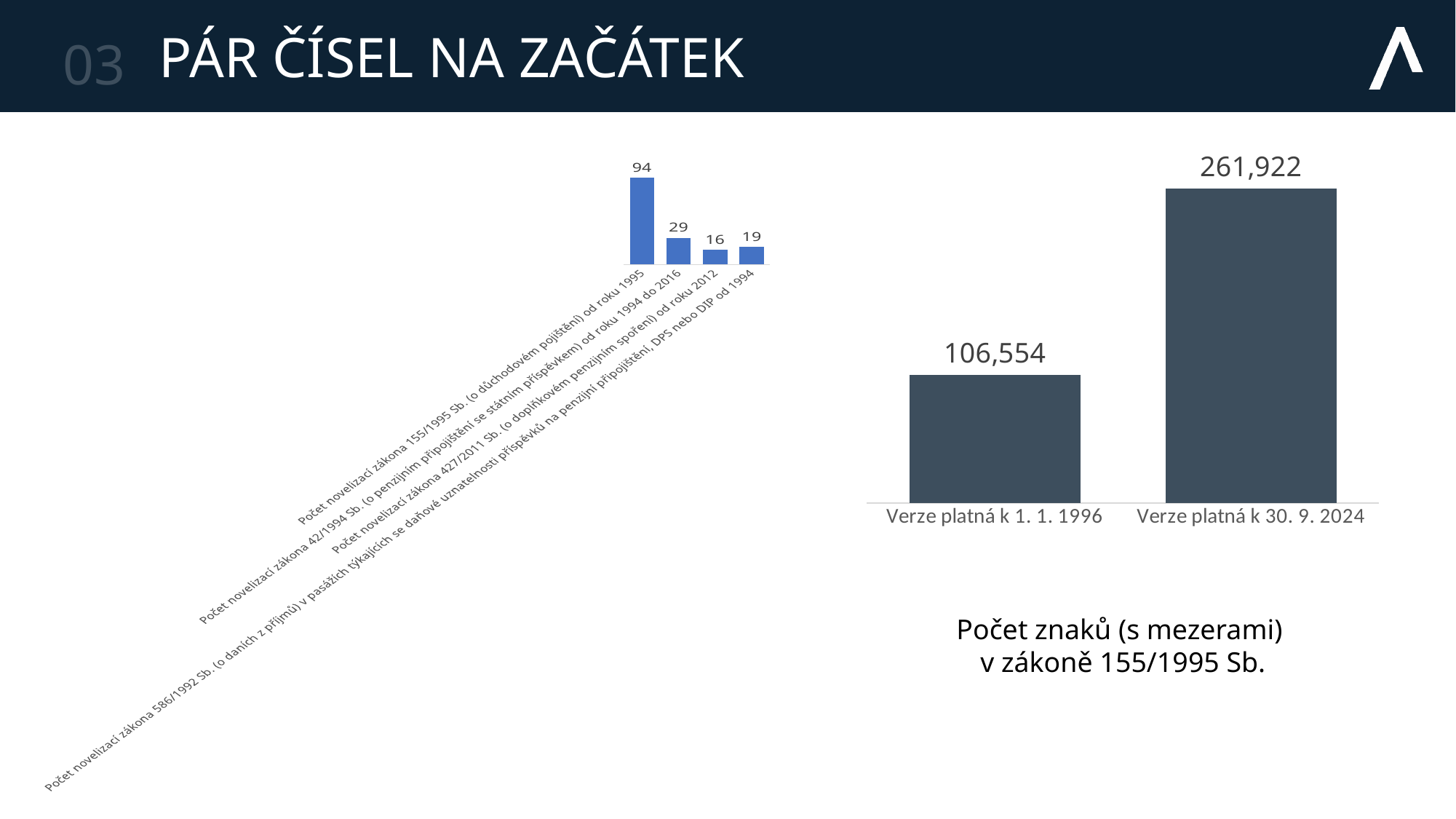
In the chart on the left, what is the difference between the values for zákon 155/1995 Sb. and zákon 42/1994 Sb.? 65 In the chart on the left, which category has the highest value? Počet novelizací zákona 155/1995 Sb. (o důchodovém pojištění) od roku 1995 In the chart on the left, what is the value for zákon 42/1994 Sb. (o penzijním připojištění se státním příspěvkem) od roku 1994 do 2016? 29 In the chart on the left, which category has the lowest value? Počet novelizací zákona 427/2011 Sb. (o doplňkovém penzijním spoření) od roku 2012 In the chart 'Počet znaků (s mezerami) v zákoně 155/1995 Sb.', what is the value for 'Verze platná k 30. 9. 2024'? 261,922 In the chart on the left, what is the value for zákon 427/2011 Sb. (o doplňkovém penzijním spoření) od roku 2012? 16 In the chart 'Počet znaků (s mezerami) v zákoně 155/1995 Sb.', what is the value for 'Verze platná k 1. 1. 1996'? 106,554 In the chart on the left, how many categories are plotted? 4 In the chart 'Počet znaků (s mezerami) v zákoně 155/1995 Sb.', which version has the larger value? Verze platná k 30. 9. 2024 In the chart on the left, how many amendments are shown for zákon 155/1995 Sb. (o důchodovém pojištění) od roku 1995? 94 In the chart 'Počet znaků (s mezerami) v zákoně 155/1995 Sb.', what is the difference between the 2024 version and the 1996 version? 155,368 What type of chart is the chart 'Počet znaků (s mezerami) v zákoně 155/1995 Sb.'? Bar chart